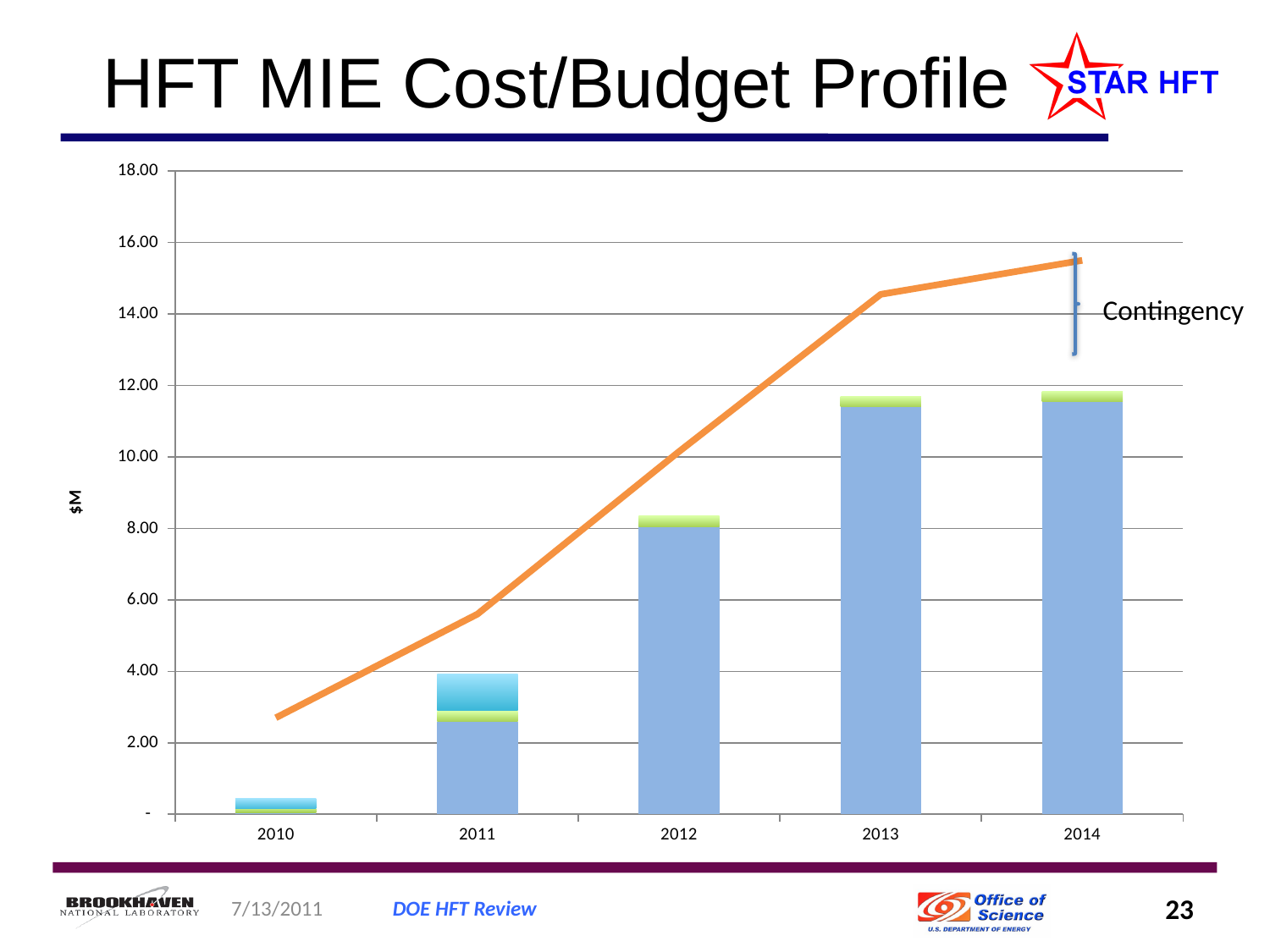
Is the value of the orange line at 2014 greater or less than 14.00? greater Is the value of the orange line at 2011 greater or less than 8.00? less Which year has the taller stacked bar, 2011 or 2012? 2012 Is the total of the stacked bar for 2013 greater or less than 10.00? greater What kind of chart is shown on the slide? Stacked bar chart with a line What is the title of the chart on the slide? HFT MIE Cost/Budget Profile What is the label on the vertical axis of the chart? $M Does the orange line rise or fall from 2010 to 2014? Rises How many years are shown along the x axis of the chart? 5 Which year has the lowest stacked bar? 2010